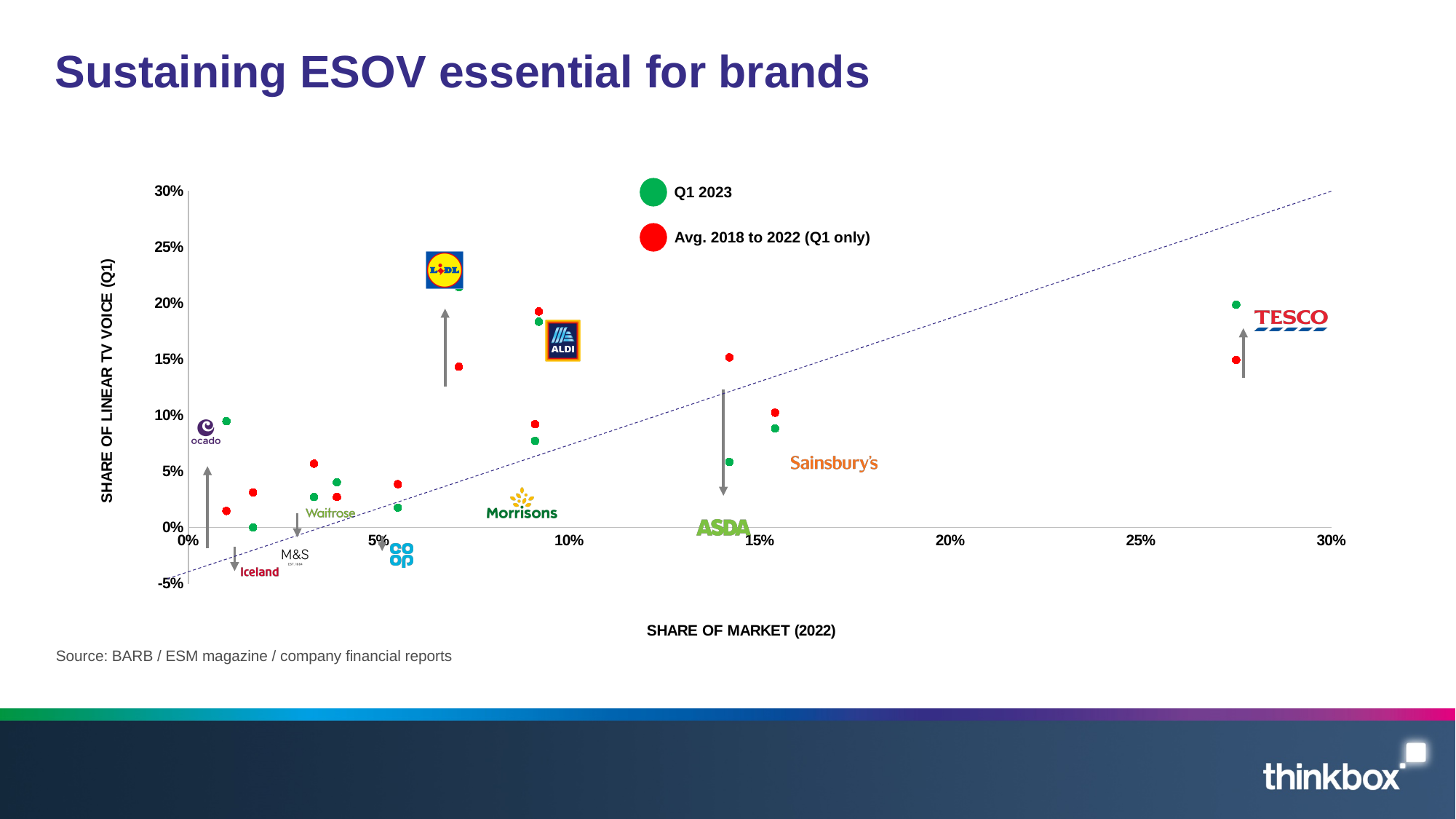
How many series does the chart legend list? 2 For Lidl, which is larger: the Q1 2023 share of voice or the Avg. 2018 to 2022 share of voice? Q1 2023 For Asda, which is larger: the Q1 2023 share of voice or the Avg. 2018 to 2022 share of voice? Avg. 2018 to 2022 Is Lidl's Q1 2023 share of linear TV voice greater or less than 20%? greater What are the two series named in the chart legend? Q1 2023; Avg. 2018 to 2022 (Q1 only) Is Tesco's Q1 2023 share of linear TV voice greater or less than 15%? greater What kind of chart is shown on the slide? Scatter chart What is the title of the vertical axis of the chart? SHARE OF LINEAR TV VOICE (Q1) Is Asda's Q1 2023 share of linear TV voice greater or less than 10%? less Which brand has the largest share of market (2022) on the chart? Tesco